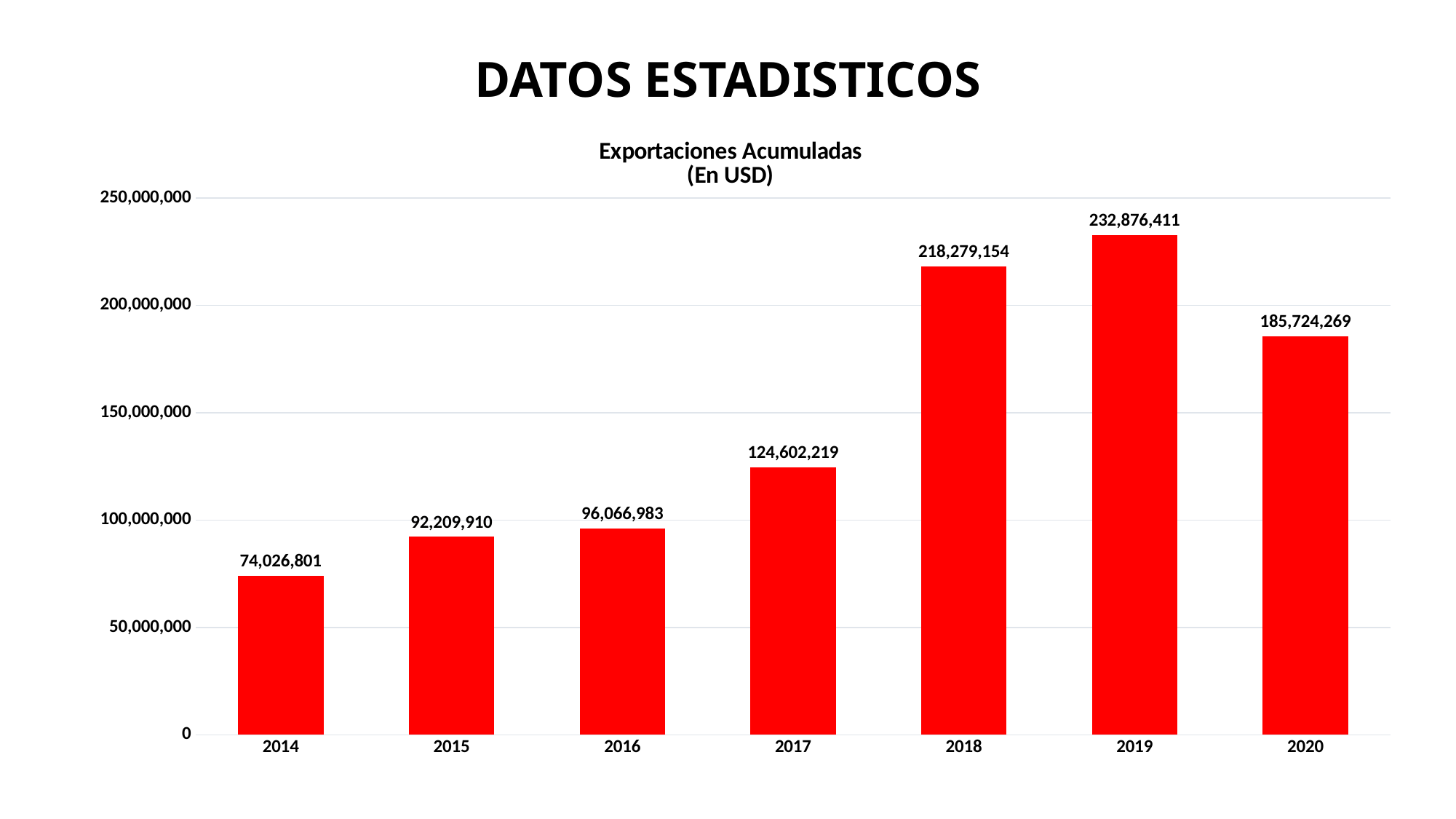
What kind of chart is shown? bar chart What is the difference between the values for 2019 and 2018? 14,597,257 How many years are shown on the x axis? 7 What is the value for 2014? 74,026,801 What is the title of the chart? Exportaciones Acumuladas (En USD) Is the value for 2016 greater or less than 100,000,000? less Which is larger, the value for 2018 or the value for 2020? 2018 What is the value for 2020? 185,724,269 Which year has the lowest value? 2014 What is the value for 2017? 124,602,219 Which year has the highest value? 2019 What is the difference between the values for 2017 and 2016? 28,535,236